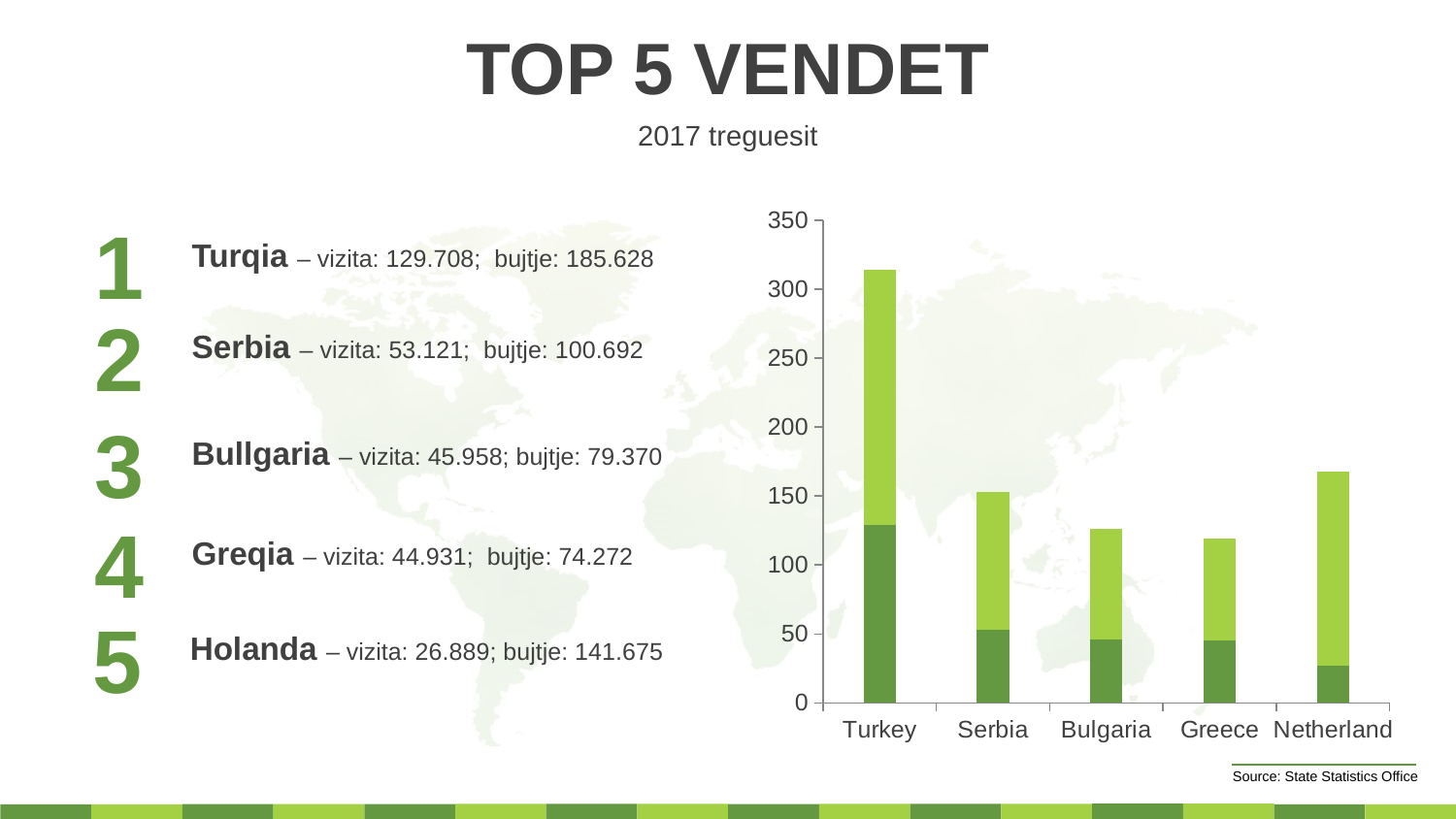
Is the dark green segment for Turkey greater or less than 100? greater Is the total bar height for Bulgaria greater or less than 150? less Do the total bar heights rise or fall from Turkey to Greece along the x axis? fall What source is cited below the chart? State Statistics Office Is the total bar height for Netherland greater or less than 150? greater What kind of chart is shown on the slide? bar chart Which country has the tallest bar in the chart? Turkey How many countries are shown on the x axis of the chart? 5 Which bar is taller in total, Serbia or Netherland? Netherland